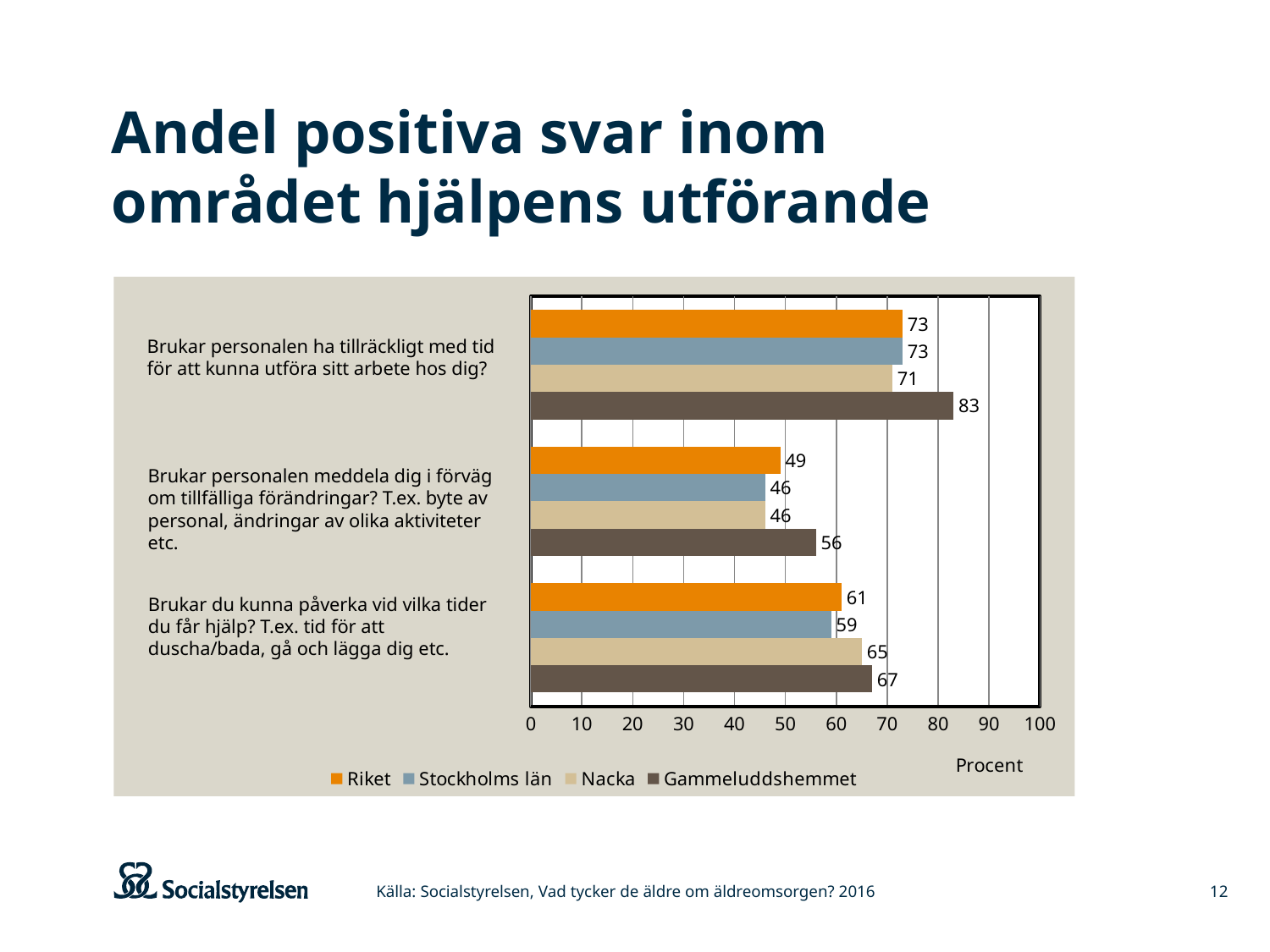
What type of chart is shown on the slide? Bar chart What is the value for Gammeluddshemmet for the question "Brukar personalen ha tillräckligt med tid för att kunna utföra sitt arbete hos dig?"? 83 What is the difference between Gammeluddshemmet and Nacka for the question "Brukar personalen ha tillräckligt med tid för att kunna utföra sitt arbete hos dig?"? 12 What unit label is shown under the x axis of the chart? Procent How many question categories are plotted on the chart? 3 Which series has the highest value for the question "Brukar personalen meddela dig i förväg om tillfälliga förändringar?"? Gammeluddshemmet What is the value for Riket for the question "Brukar personalen meddela dig i förväg om tillfälliga förändringar?"? 49 What is the value for Nacka for the question "Brukar du kunna påverka vid vilka tider du får hjälp?"? 65 How many series does the legend list? 4 Which is larger for the question "Brukar du kunna påverka vid vilka tider du får hjälp?": Riket or Nacka? Nacka What is the value for Stockholms län for the question "Brukar personalen meddela dig i förväg om tillfälliga förändringar?"? 46 Which series has the lowest value for the question "Brukar du kunna påverka vid vilka tider du får hjälp?"? Stockholms län